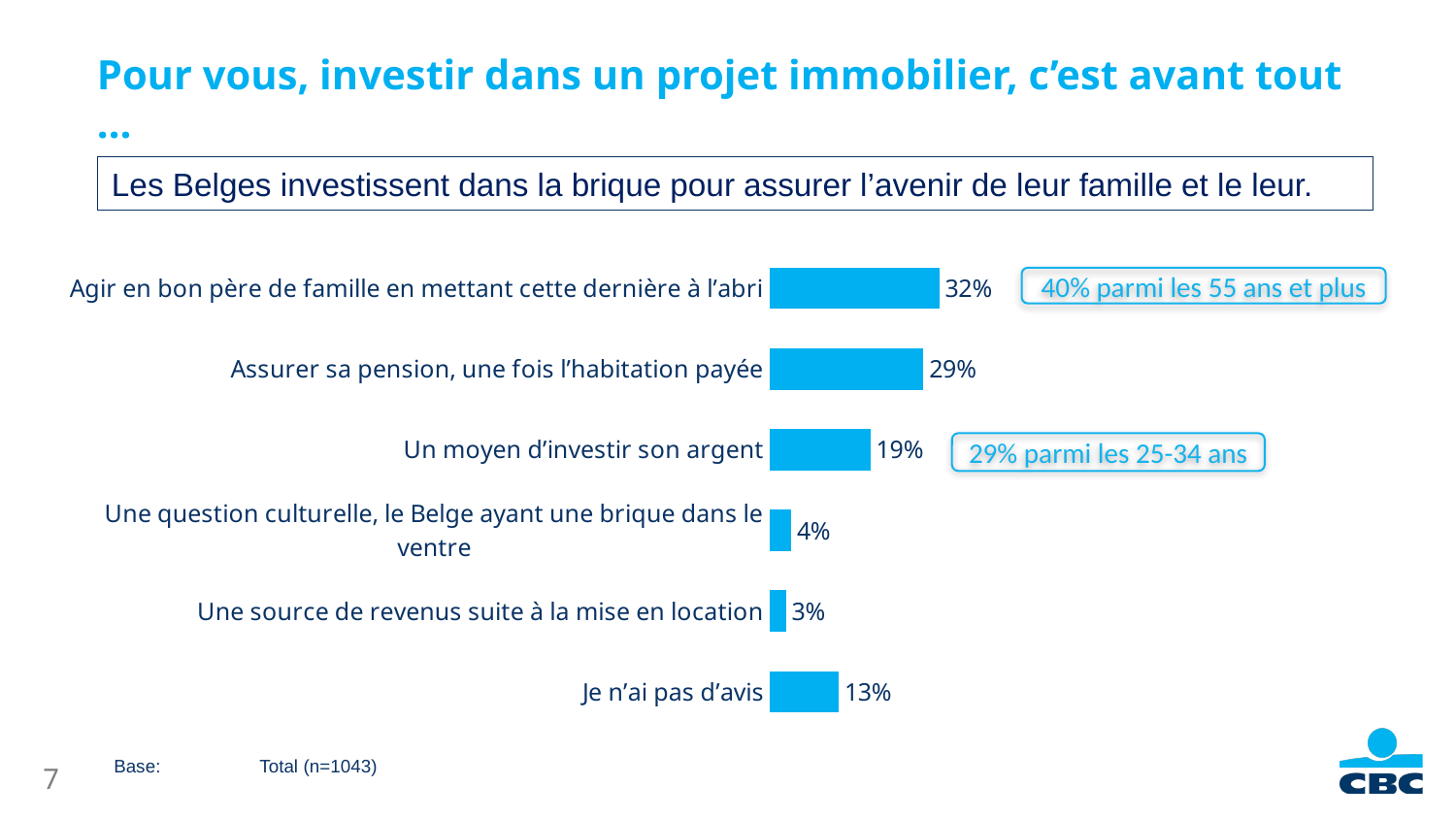
What is the difference between "Une question culturelle, le Belge ayant une brique dans le ventre" and "Une source de revenus suite à la mise en location"? 1% What is the value for "Je n'ai pas d'avis"? 13% Which is larger: "Un moyen d'investir son argent" or "Je n'ai pas d'avis"? Un moyen d'investir son argent According to the callout, what share of those aged 55 and over chose "Agir en bon père de famille en mettant cette dernière à l'abri"? 40% What kind of chart is shown on the slide? Bar chart What is the difference between "Agir en bon père de famille en mettant cette dernière à l'abri" and "Assurer sa pension, une fois l'habitation payée"? 3% What is the value for "Un moyen d'investir son argent"? 19% How many categories are shown in the chart? 6 What is the value for "Assurer sa pension, une fois l'habitation payée"? 29% What is the base (sample size) stated below the chart? Total (n=1043) Which category has the lowest value? Une source de revenus suite à la mise en location Which category has the highest value? Agir en bon père de famille en mettant cette dernière à l'abri